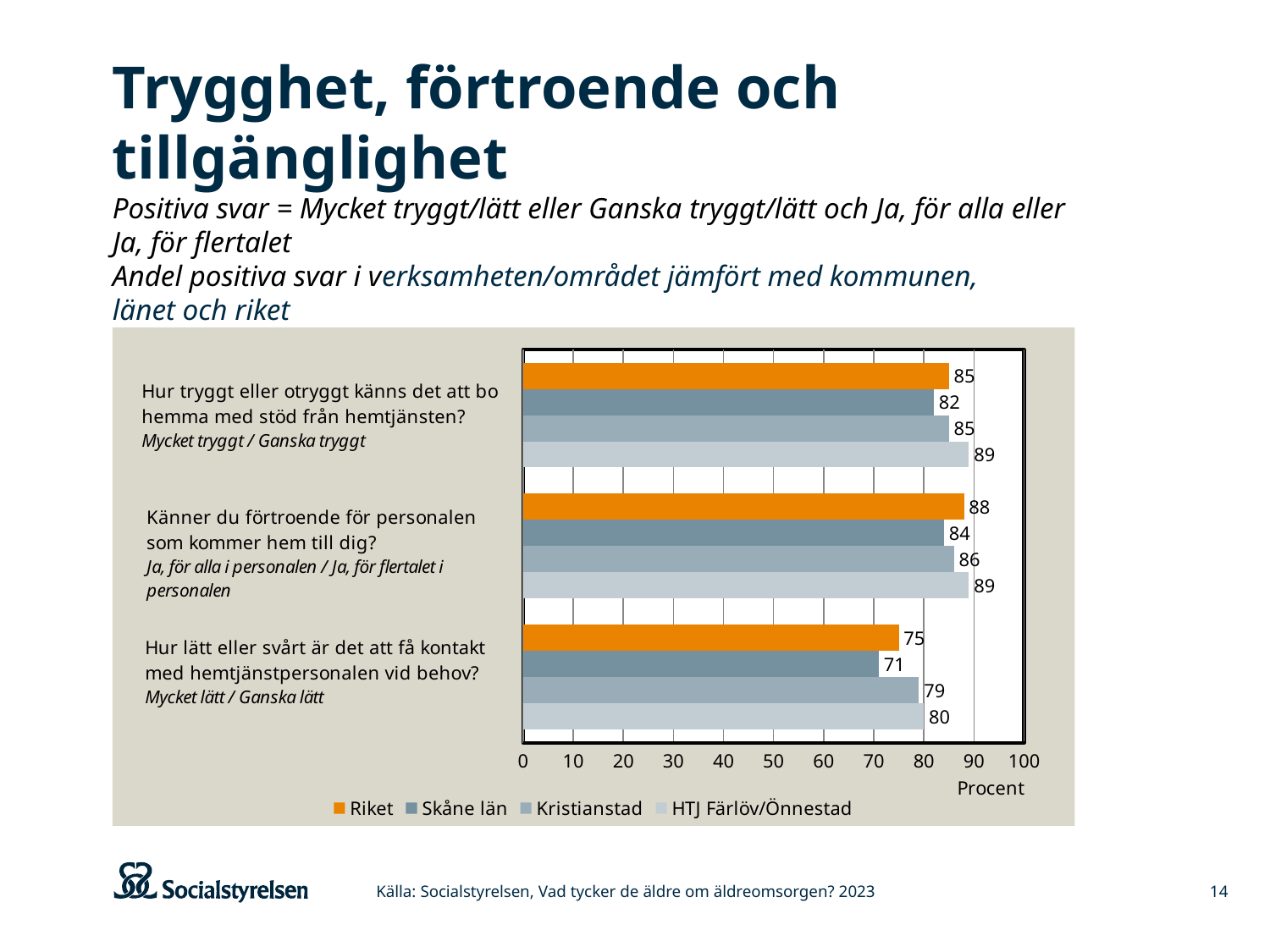
What is the value for Riket on the question "Hur tryggt eller otryggt känns det att bo hemma med stöd från hemtjänsten?"? 85 Which is larger on the question "Hur lätt eller svårt är det att få kontakt med hemtjänstpersonalen vid behov?": Kristianstad or Riket? Kristianstad What is the value for HTJ Färlöv/Önnestad on the question "Känner du förtroende för personalen som kommer hem till dig?"? 89 How many question categories are shown on the chart? 3 What is the label on the horizontal axis of the chart? Procent Which series has the highest value on the question "Hur tryggt eller otryggt känns det att bo hemma med stöd från hemtjänsten?"? HTJ Färlöv/Önnestad What kind of chart is shown on the slide? Bar chart What is the difference between Riket and Skåne län on the question "Känner du förtroende för personalen som kommer hem till dig?"? 4 What is the difference between HTJ Färlöv/Önnestad and Skåne län on the question "Hur tryggt eller otryggt känns det att bo hemma med stöd från hemtjänsten?"? 7 What is the value for Skåne län on the question "Hur lätt eller svårt är det att få kontakt med hemtjänstpersonalen vid behov?"? 71 How many series does the legend list? 4 Which series has the lowest value on the question "Hur lätt eller svårt är det att få kontakt med hemtjänstpersonalen vid behov?"? Skåne län